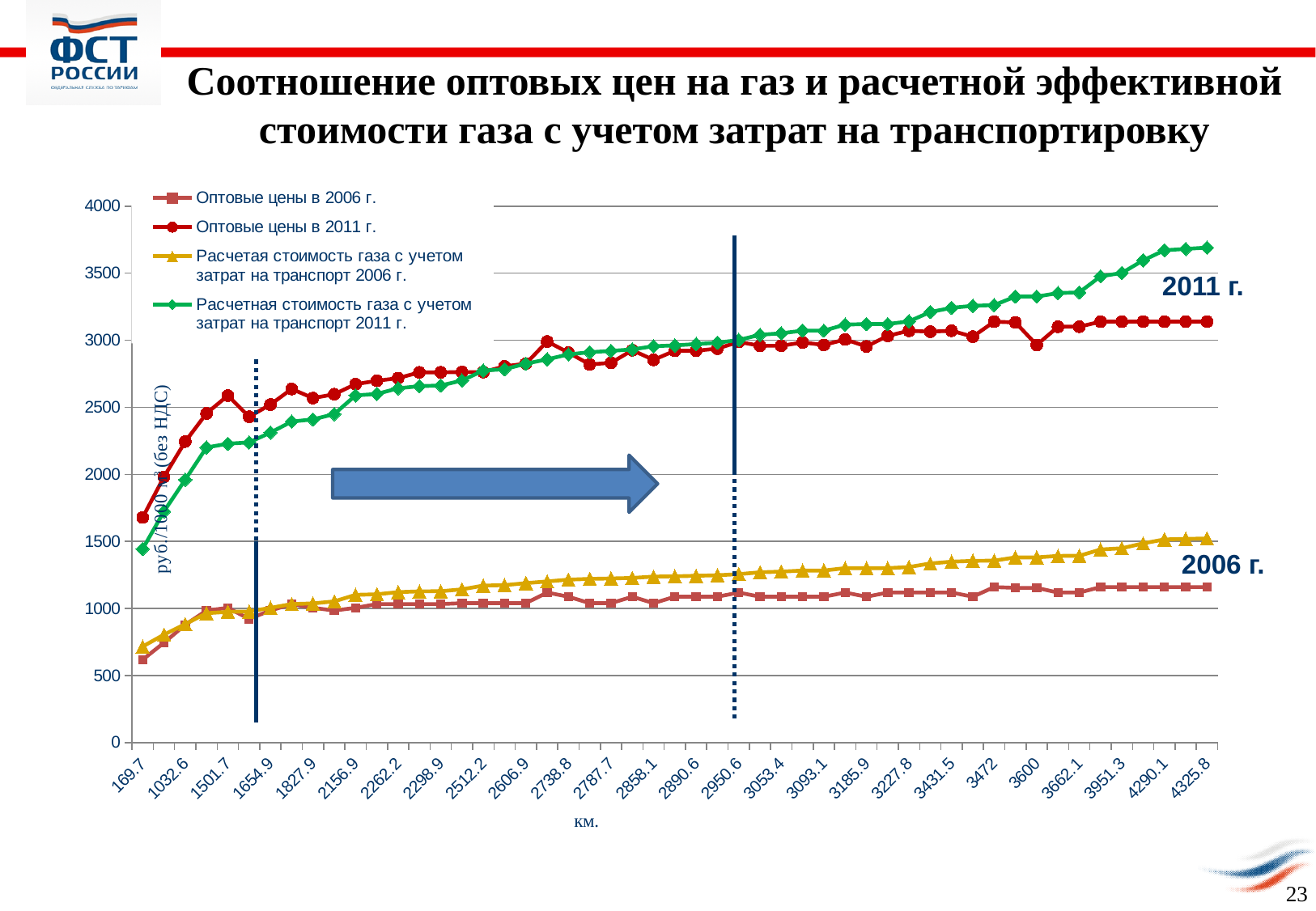
Do the values of the series 'Расчетная стоимость газа с учетом затрат на транспорт 2011 г.' rise or fall along the x axis? rise What is the first entry in the chart legend? Оптовые цены в 2006 г. Is the value for 'Оптовые цены в 2006 г.' at 169.7 km greater or less than 1000? less Is the value for 'Оптовые цены в 2011 г.' at 169.7 km greater or less than 2000? less Is the value for 'Оптовые цены в 2006 г.' at 4325.8 km greater or less than 1500? less At 169.7 km, which is larger: 'Оптовые цены в 2011 г.' or 'Расчетная стоимость газа с учетом затрат на транспорт 2011 г.'? Оптовые цены в 2011 г. What unit is shown on the x axis of the chart? км. How many series does the legend list? 4 Do the values of the series 'Расчетая стоимость газа с учетом затрат на транспорт 2006 г.' rise or fall along the x axis? rise At 4325.8 km, which is larger: 'Расчетная стоимость газа с учетом затрат на транспорт 2011 г.' or 'Оптовые цены в 2011 г.'? Расчетная стоимость газа с учетом затрат на транспорт 2011 г. What kind of chart is shown on the slide? line chart